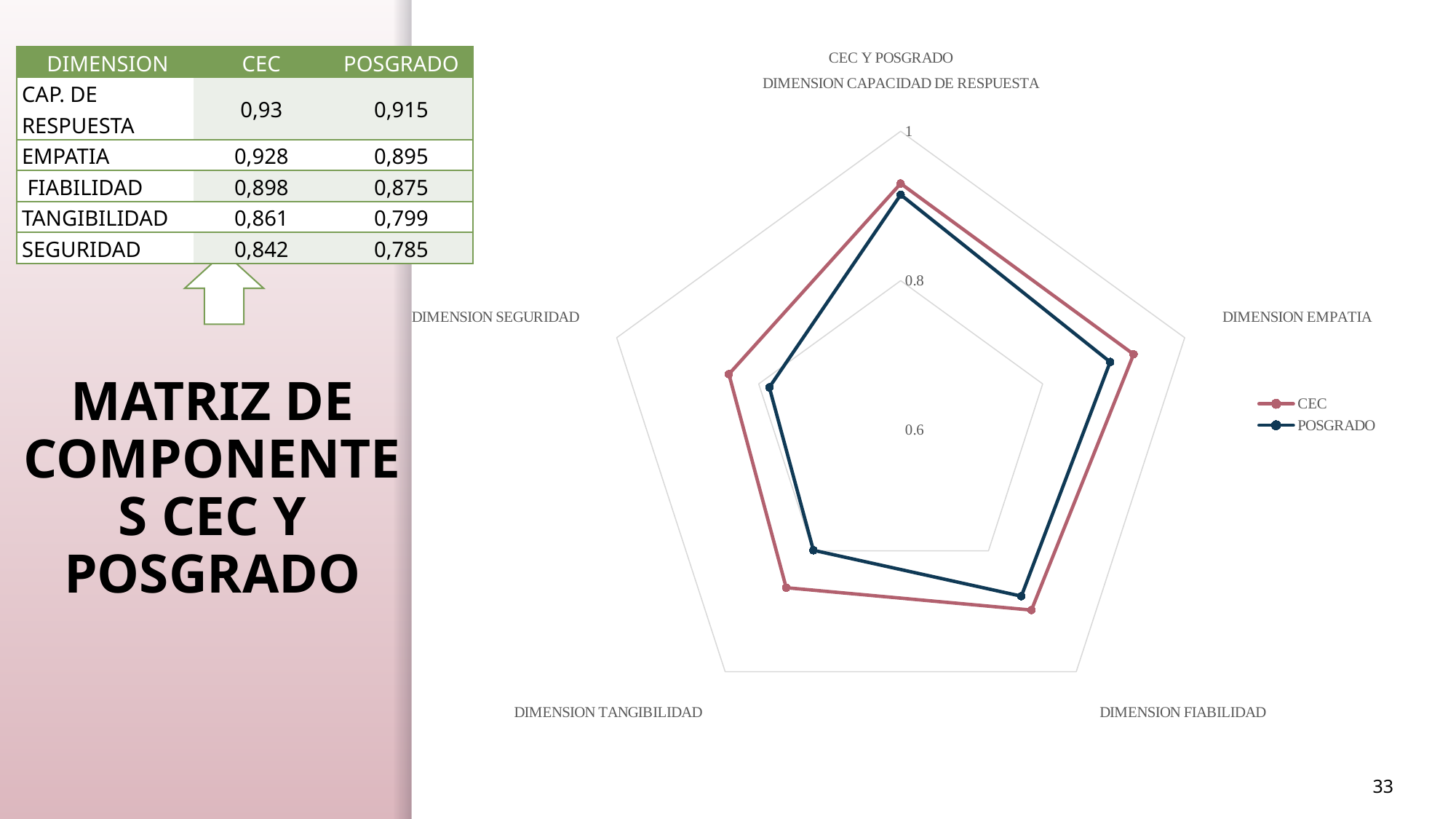
How many series does the chart legend list? 2 What is the title of the chart? CEC Y POSGRADO Is the POSGRADO value for DIMENSION SEGURIDAD greater or less than 0.8? less Which dimension has the highest CEC value? DIMENSION CAPACIDAD DE RESPUESTA Is the CEC value for DIMENSION EMPATIA greater or less than 0.8? greater Which dimension has the lowest POSGRADO value? DIMENSION SEGURIDAD Which series has the larger value for DIMENSION TANGIBILIDAD, CEC or POSGRADO? CEC How many dimensions (axes) does the radar chart have? 5 What is the CEC value for DIMENSION CAPACIDAD DE RESPUESTA? 0,93 What kind of chart is shown on the slide? Radar chart What is the difference between the CEC and POSGRADO values for DIMENSION TANGIBILIDAD? 0,062 What is the POSGRADO value for DIMENSION SEGURIDAD? 0,785